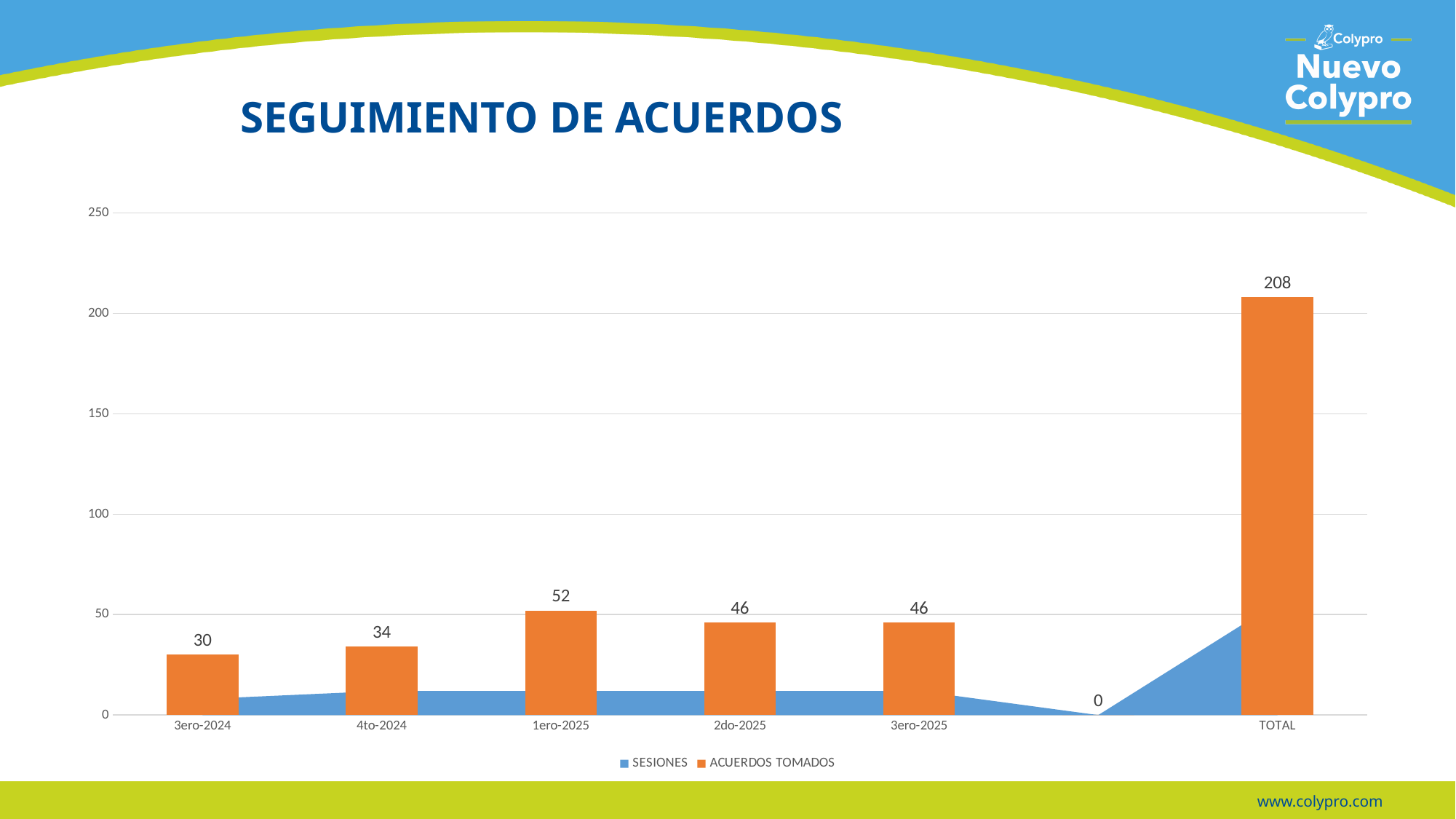
What is the value of ACUERDOS TOMADOS for TOTAL? 208 Among the five quarterly periods (excluding TOTAL), which has the lowest ACUERDOS TOMADOS value? 3ero-2024 What is the difference between the ACUERDOS TOMADOS values for 1ero-2025 and 3ero-2024? 22 What is the value of ACUERDOS TOMADOS for 4to-2024? 34 Among the five quarterly periods (excluding TOTAL), which has the highest ACUERDOS TOMADOS value? 1ero-2025 What is the value of ACUERDOS TOMADOS for 1ero-2025? 52 Is the SESIONES value for 1ero-2025 greater or less than 50? less What is the value of ACUERDOS TOMADOS for 3ero-2024? 30 Is the ACUERDOS TOMADOS value for TOTAL greater or less than 200? greater How many series does the legend list? 2 Do the ACUERDOS TOMADOS values rise or fall from 3ero-2024 to 1ero-2025? rise Which has a larger ACUERDOS TOMADOS value, 4to-2024 or 2do-2025? 2do-2025